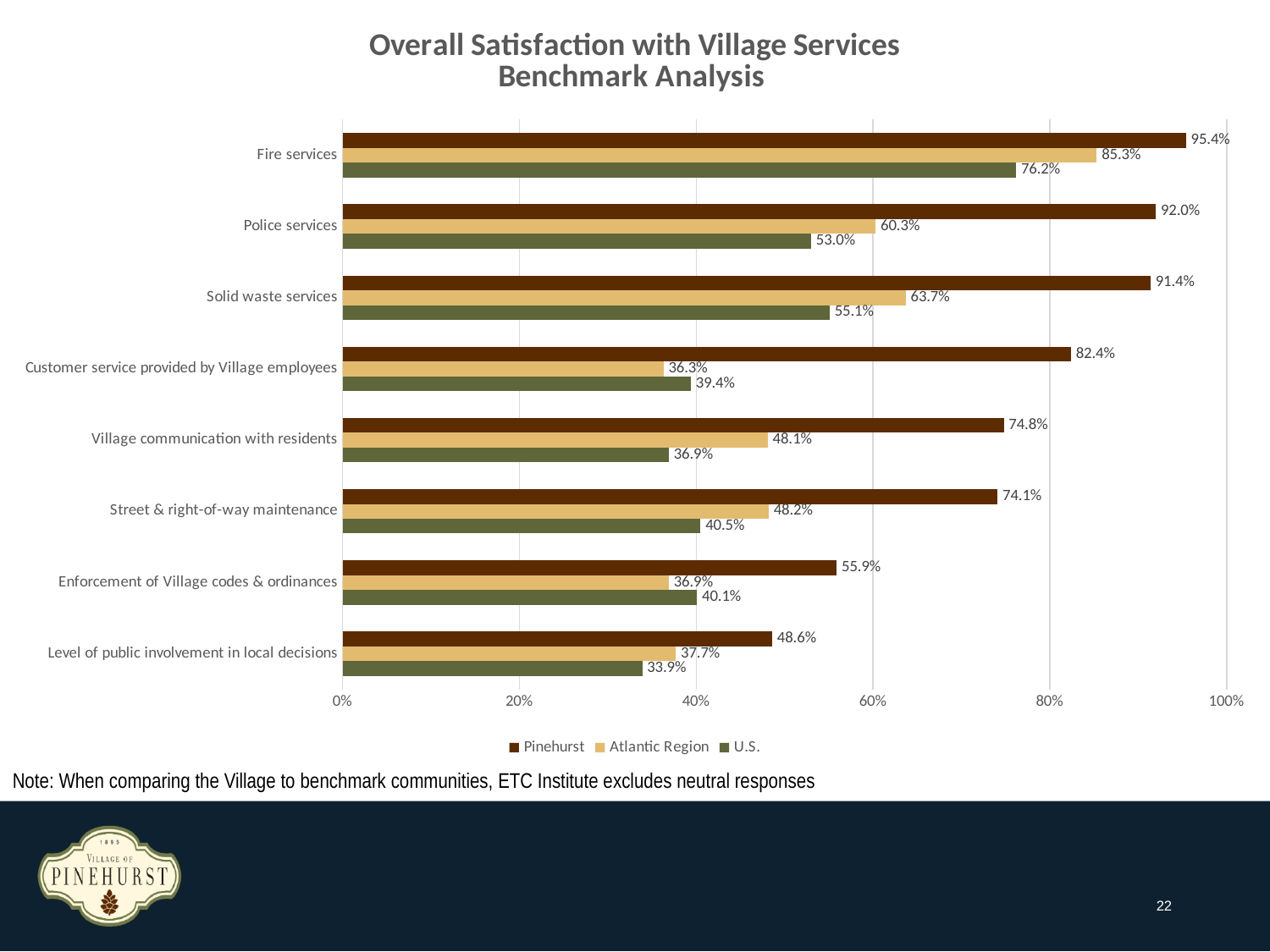
Which category has the lowest U.S. value? Level of public involvement in local decisions Which category has the highest Pinehurst value? Fire services What is the difference between the Pinehurst and U.S. values for Customer service provided by Village employees? 43.0% How many service categories are shown on the chart? 8 Is the Pinehurst value for Street & right-of-way maintenance greater or less than 60%? greater What is the Atlantic Region value for Solid waste services? 63.7% For Enforcement of Village codes & ordinances, which is larger: the Atlantic Region value or the U.S. value? U.S. How many series does the legend list? 3 What is the Pinehurst value for Fire services? 95.4% What is the title of the chart? Overall Satisfaction with Village Services Benchmark Analysis What kind of chart is shown on the slide? Bar chart What is the U.S. value for Police services? 53.0%